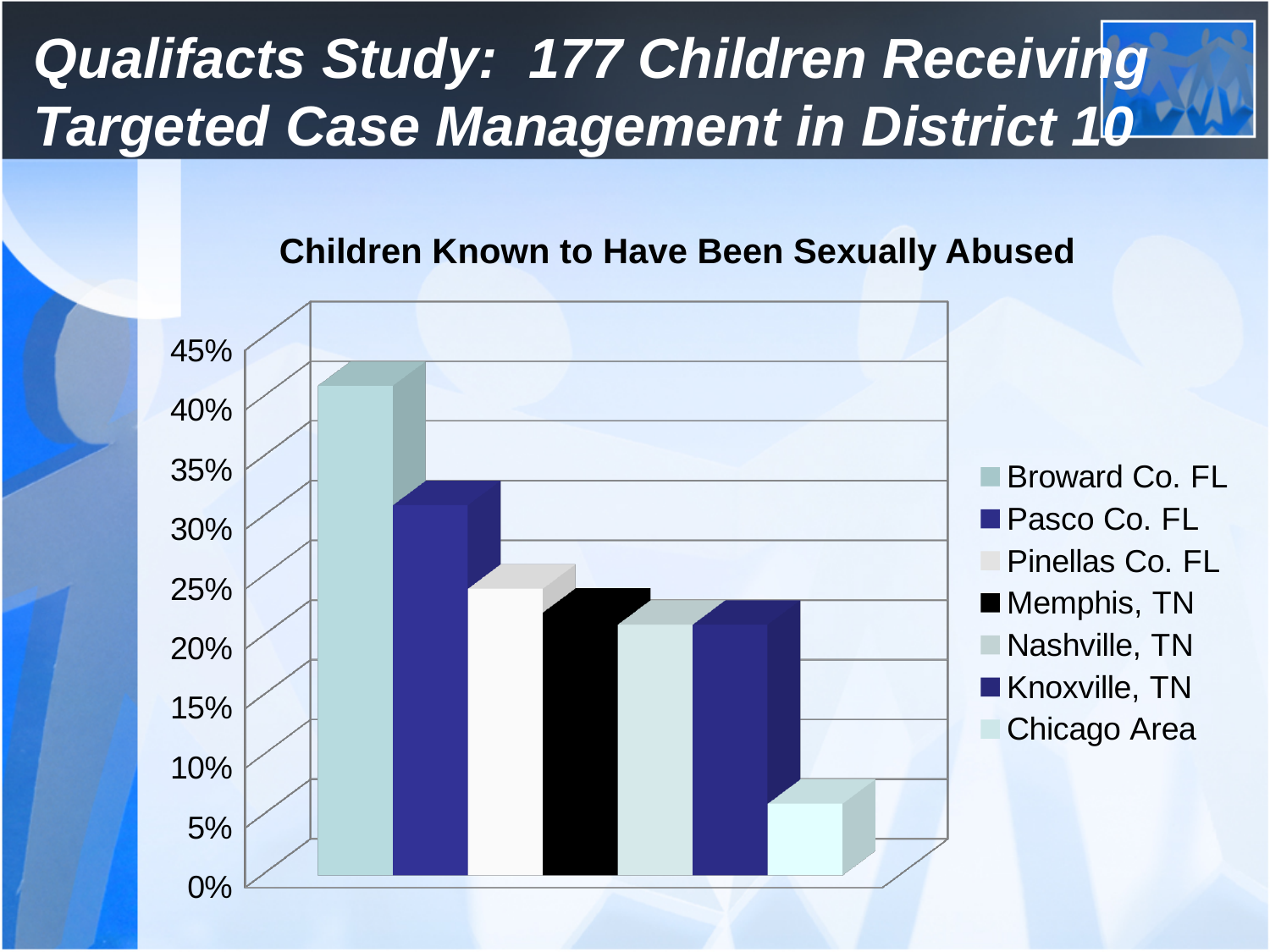
Do the bar values generally rise or fall from left to right across the chart? fall How many entries does the chart's legend list? 7 Which is larger, the value for Pasco Co. FL or the value for Chicago Area? Pasco Co. FL How many bars are plotted in the chart? 7 What kind of chart is shown on the slide? bar chart Is the value for Broward Co. FL greater or less than 35%? greater What is the title of the chart? Children Known to Have Been Sexually Abused Is the value for Chicago Area greater or less than 10%? less Which is larger, the value for Broward Co. FL or the value for Pasco Co. FL? Broward Co. FL Which location has the highest value in the chart? Broward Co. FL Is the value for Pasco Co. FL greater or less than 25%? greater Which location has the lowest value in the chart? Chicago Area